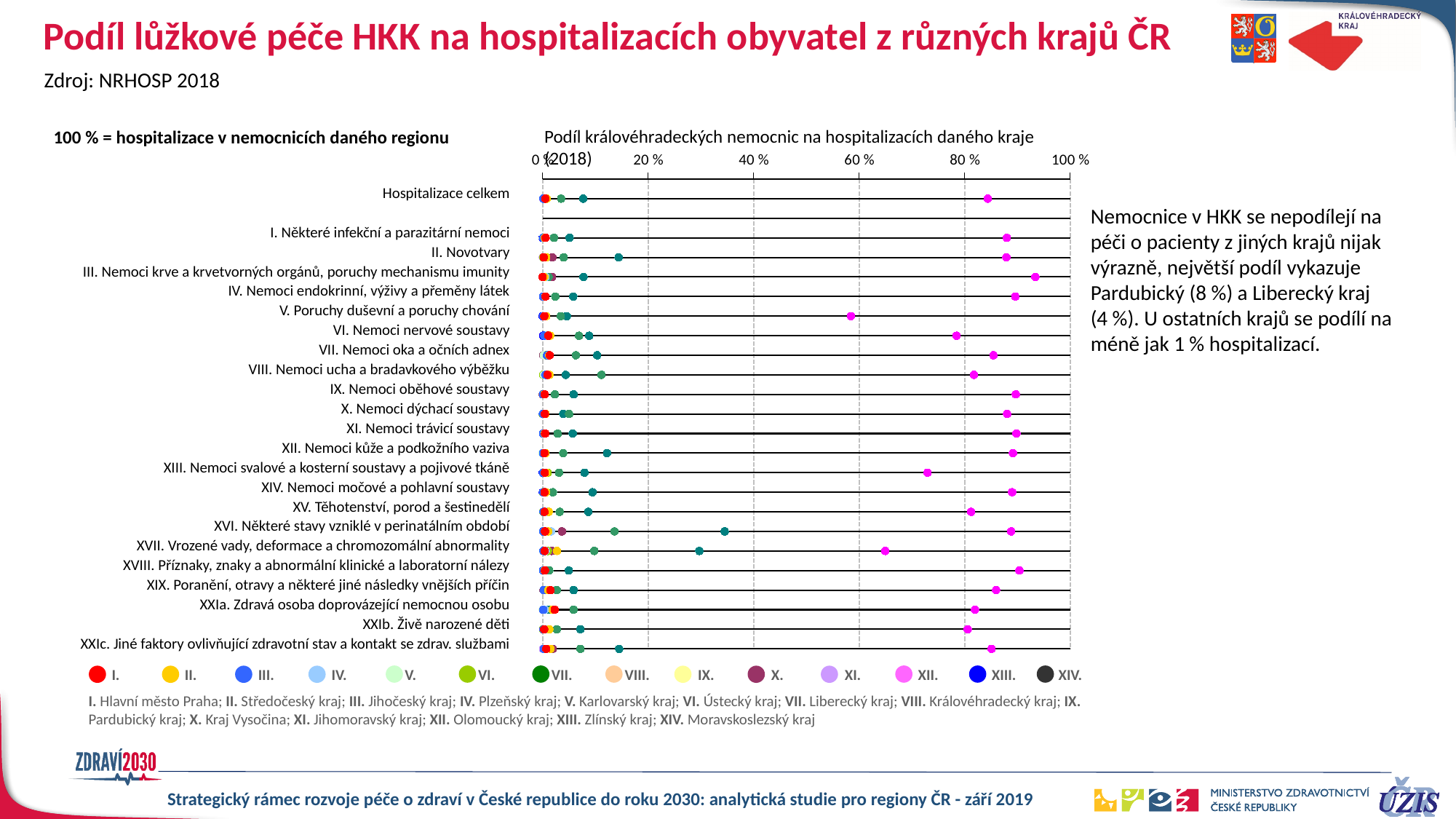
How many categories (rows) are plotted on the chart? 23 What kind of chart is shown on the slide? dot plot (scatter chart) Is the rightmost point for 'XVII. Vrozené vady, deformace a chromozomální abnormality' greater or less than 80 %? less Is the rightmost point for 'XIII. Nemoci svalové a kosterní soustavy a pojivové tkáně' greater or less than 60 %? greater How many series does the legend list? 14 Is the rightmost point for 'Hospitalizace celkem' greater or less than 80 %? greater What is the title of the chart? Podíl královéhradeckých nemocnic na hospitalizacích daného kraje (2018) Which category has the lowest rightmost point on the chart? V. Poruchy duševní a poruchy chování What is the highest value shown on the x axis? 100 % Which has a larger rightmost point: 'XIII. Nemoci svalové a kosterní soustavy a pojivové tkáně' or 'XV. Těhotenství, porod a šestinedělí'? XV. Těhotenství, porod a šestinedělí